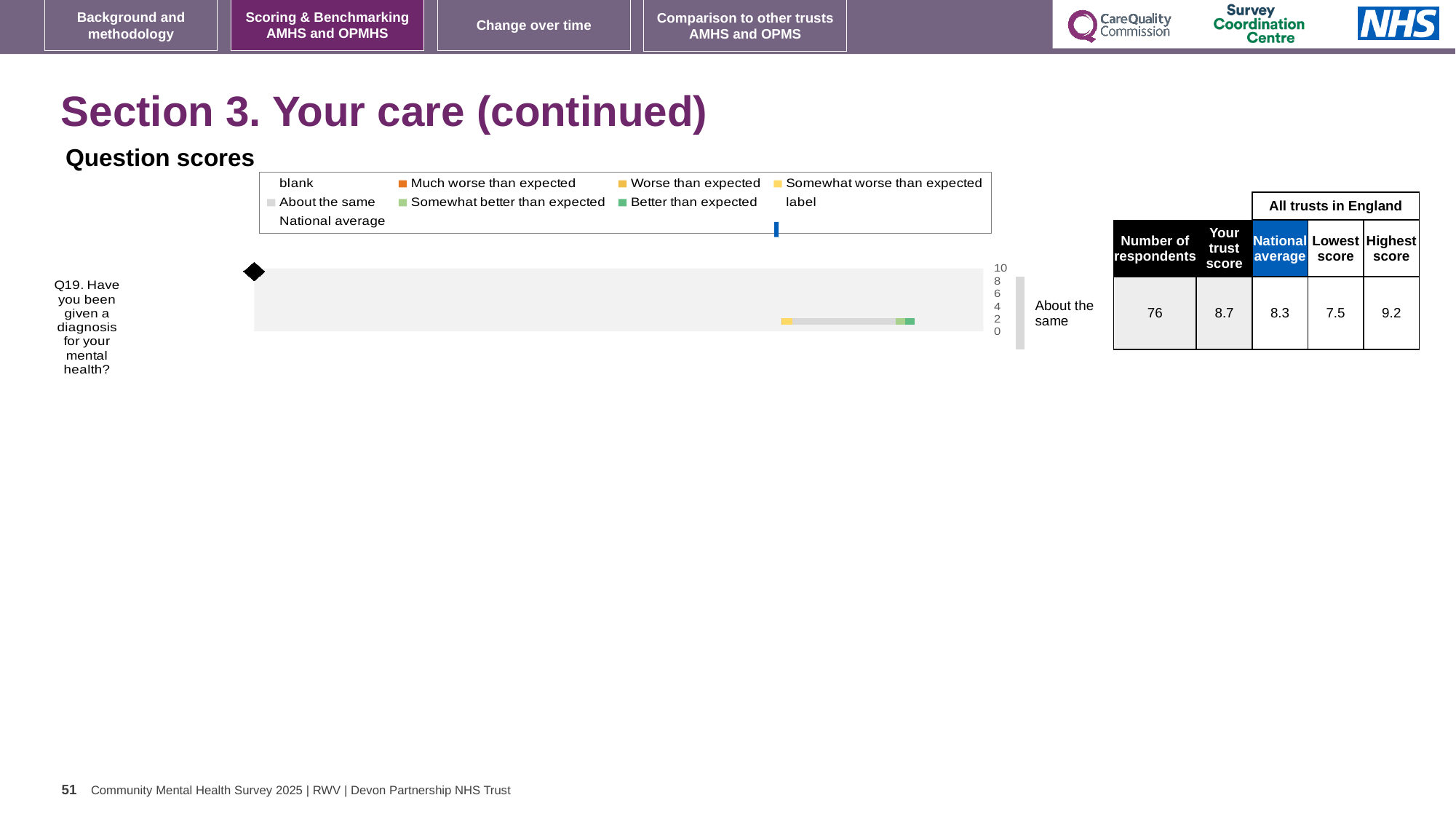
What kind of chart is shown under 'Question scores'? bar chart How many respondents are listed for Q19 in the table next to the chart? 76 For Q19, which is larger: the trust score or the national average? trust score What is the national average for Q19 shown in the table next to the chart? 8.3 For Q19, what is the difference between the highest score and the lowest score among all trusts in England? 1.7 What benchmark category is shown for Q19 in the 'Question scores' chart? About the same What is the trust score for Q19 shown in the table next to the chart? 8.7 What is the lowest score among all trusts in England for Q19? 7.5 How many questions are plotted in the 'Question scores' chart? 1 What is the title of the chart on the slide? Question scores What is the highest score among all trusts in England for Q19? 9.2 How many entries does the legend of the 'Question scores' chart list? 9